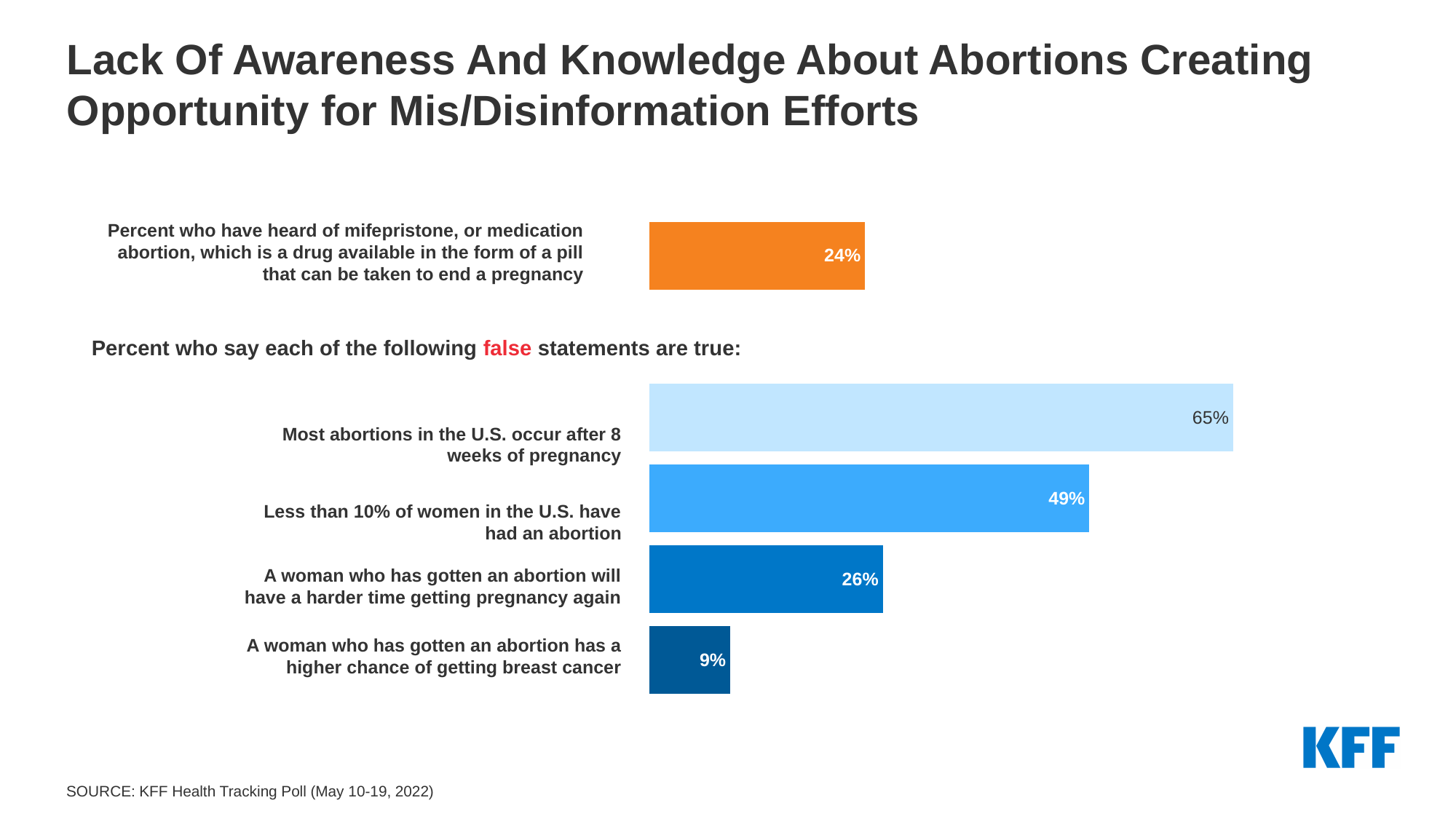
What colour is the bar in the top chart showing the percent who have heard of mifepristone? Orange How many false statements are plotted in the bottom chart? 4 In the bottom chart, what percent say the false statement 'Most abortions in the U.S. occur after 8 weeks of pregnancy' is true? 65% In the bottom chart, what is the difference between the percent for 'Most abortions in the U.S. occur after 8 weeks of pregnancy' and the percent for 'Less than 10% of women in the U.S. have had an abortion'? 16 percentage points In the bottom chart, what is the difference between the percent for 'A woman who has gotten an abortion will have a harder time getting pregnancy again' and the percent for 'A woman who has gotten an abortion has a higher chance of getting breast cancer'? 17 percentage points What kind of chart is the bottom chart? Bar chart In the top chart, what percent have heard of mifepristone, or medication abortion? 24% In the bottom chart, which false statement has the lowest percent saying it is true? A woman who has gotten an abortion has a higher chance of getting breast cancer In the bottom chart, which false statement has the highest percent saying it is true? Most abortions in the U.S. occur after 8 weeks of pregnancy In the bottom chart, what percent say 'A woman who has gotten an abortion has a higher chance of getting breast cancer' is true? 9% Which is larger: the percent who have heard of mifepristone in the top chart, or the percent in the bottom chart who say 'A woman who has gotten an abortion will have a harder time getting pregnancy again' is true? A woman who has gotten an abortion will have a harder time getting pregnancy again (26%) In the bottom chart, what percent say 'Less than 10% of women in the U.S. have had an abortion' is true? 49%